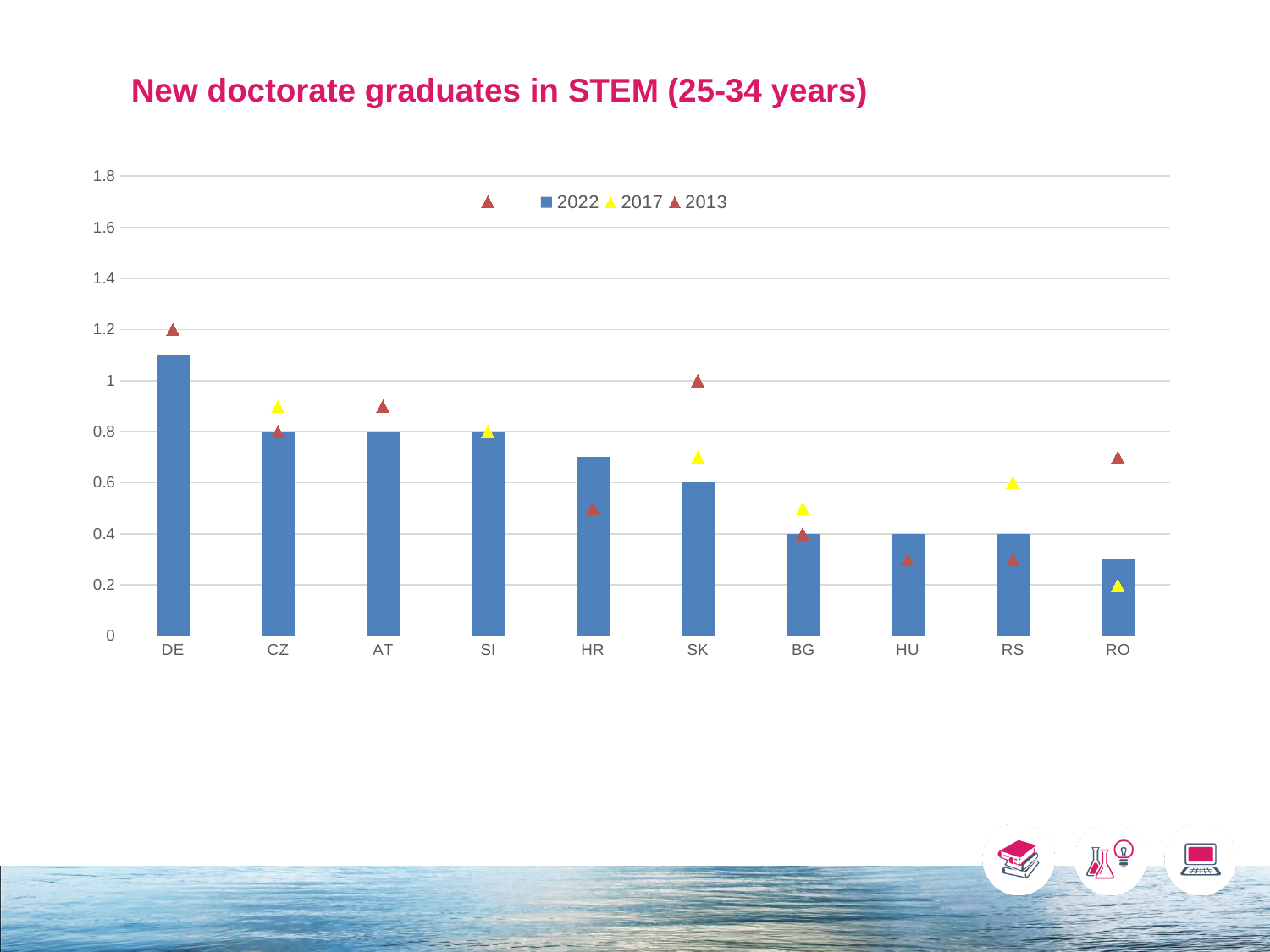
Which country has the lowest 2022 value? RO Do the 2022 values generally rise or fall from DE to RO along the x axis? fall What is the 2013 value for DE? 1.2 How many series does the legend list? 3 What is the 2017 value for RO? 0.2 Which country has the highest 2022 value? DE How many countries are shown on the x axis? 10 Which colour marks the 2017 series in the legend? yellow What type of chart is shown on the slide? combination chart (bars with triangle markers) What is the 2022 value for SK? 0.6 What is the 2022 value for CZ? 0.8 Is the 2022 value for DE greater or less than 1? greater